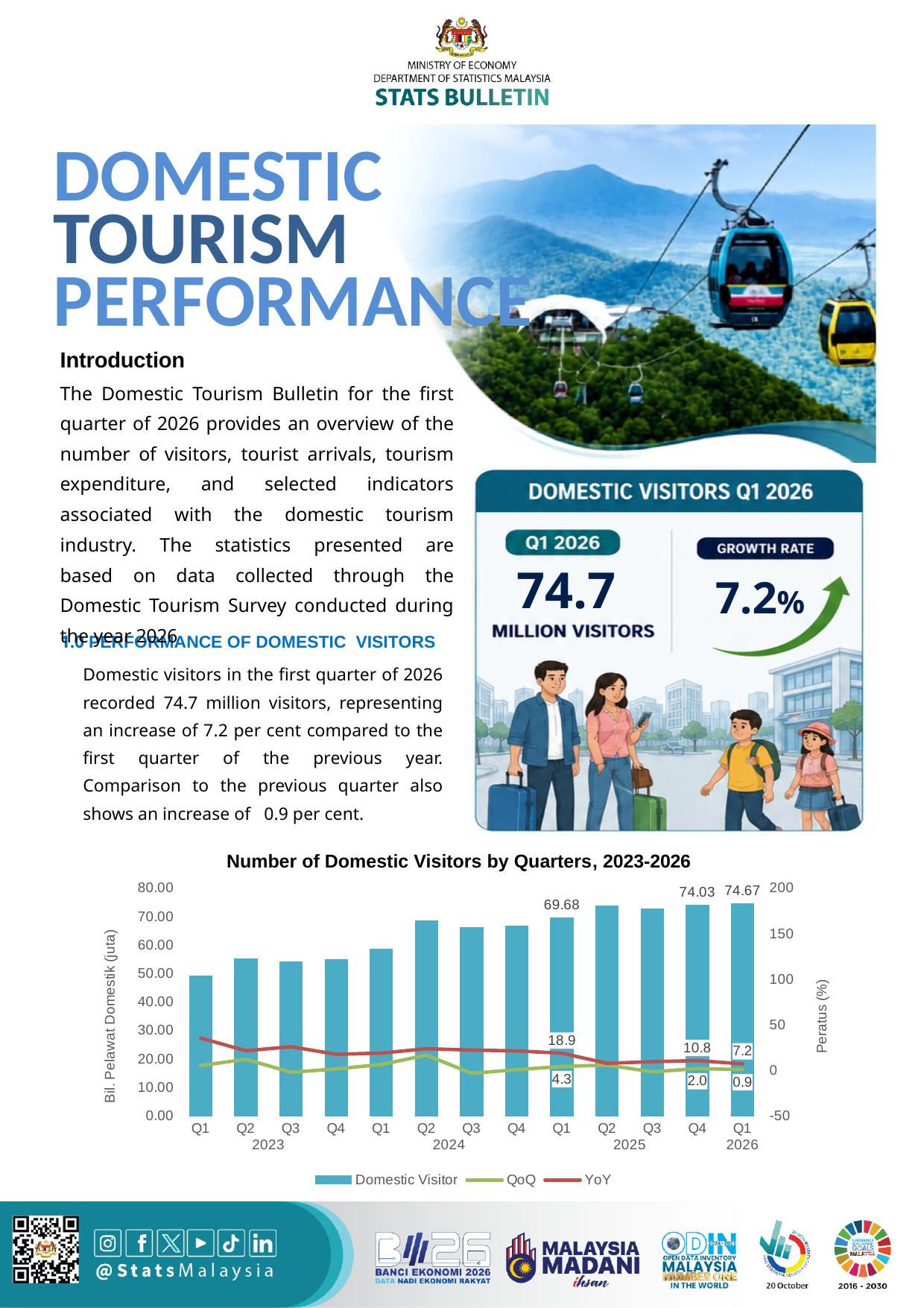
Which quarter has the highest Domestic Visitor bar? Q1 2026 How many series does the legend list? 3 Which quarter has the lowest Domestic Visitor bar? Q1 2023 Is the Domestic Visitor value for Q1 2024 greater or less than 50.00? greater What is the value of the Domestic Visitor bar for Q1 2026? 74.67 What is the QoQ value shown for Q1 2026? 0.9 Which is larger, the QoQ value for Q1 2025 or the QoQ value for Q4 2025? Q1 2025 How many quarters are plotted on the x axis? 13 What is the difference between the YoY values for Q1 2025 and Q1 2026? 11.7 What is the YoY value shown for Q4 2025? 10.8 What is the value of the Domestic Visitor bar for Q1 2025? 69.68 What is the difference between the Domestic Visitor values for Q1 2026 and Q4 2025? 0.64